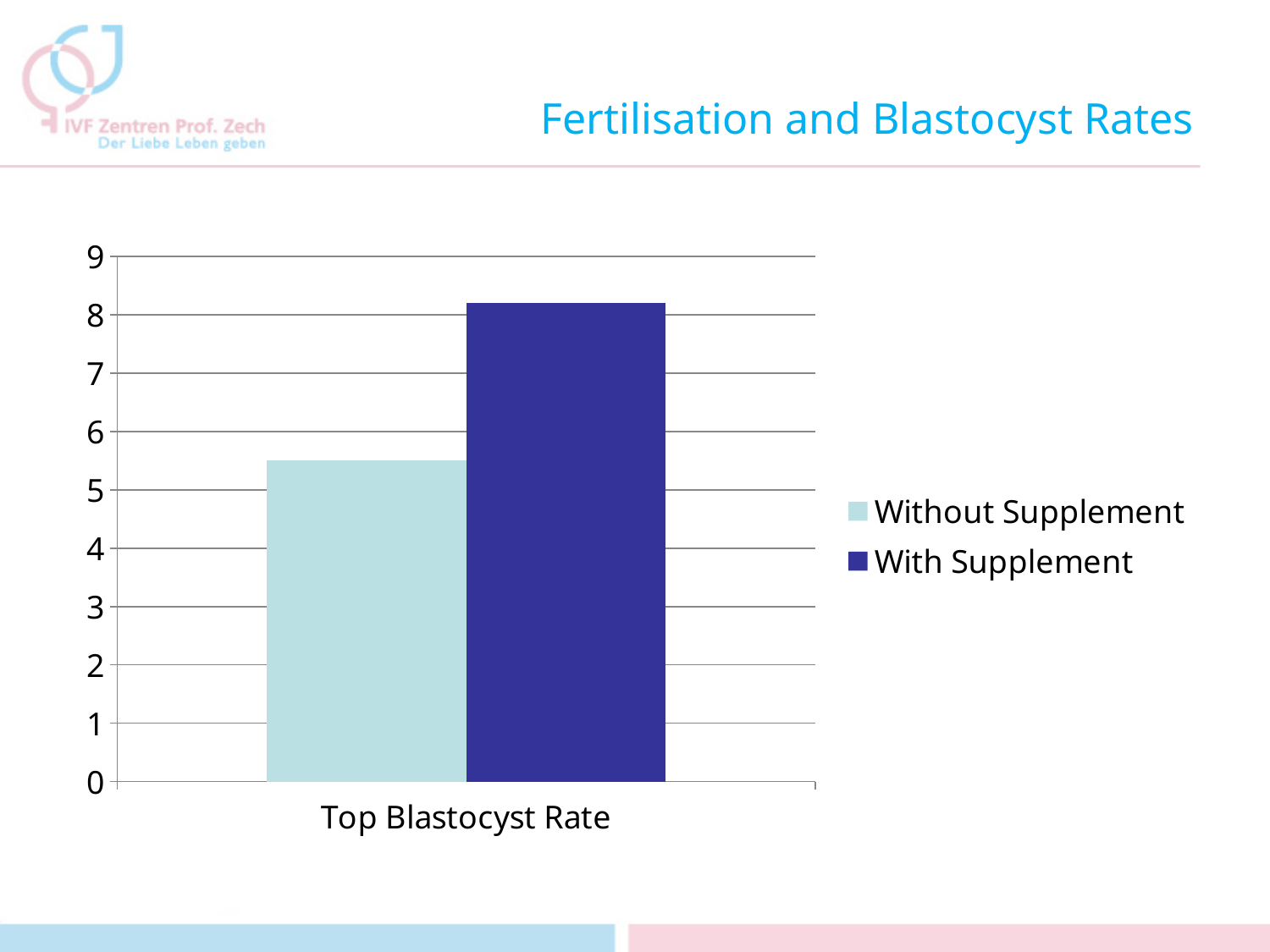
Is the value for With Supplement greater or less than 9? less Is the value for Without Supplement greater or less than 5? greater Which series has the highest bar in the chart? With Supplement What kind of chart is shown on the slide? bar chart Which series has the lowest bar in the chart? Without Supplement Is the value for Without Supplement greater or less than 6? less What is the category label shown on the x axis? Top Blastocyst Rate How many categories are shown on the x axis? 1 Which series is shown in dark blue? With Supplement Which series has the higher value for Top Blastocyst Rate? With Supplement How many series does the legend list? 2